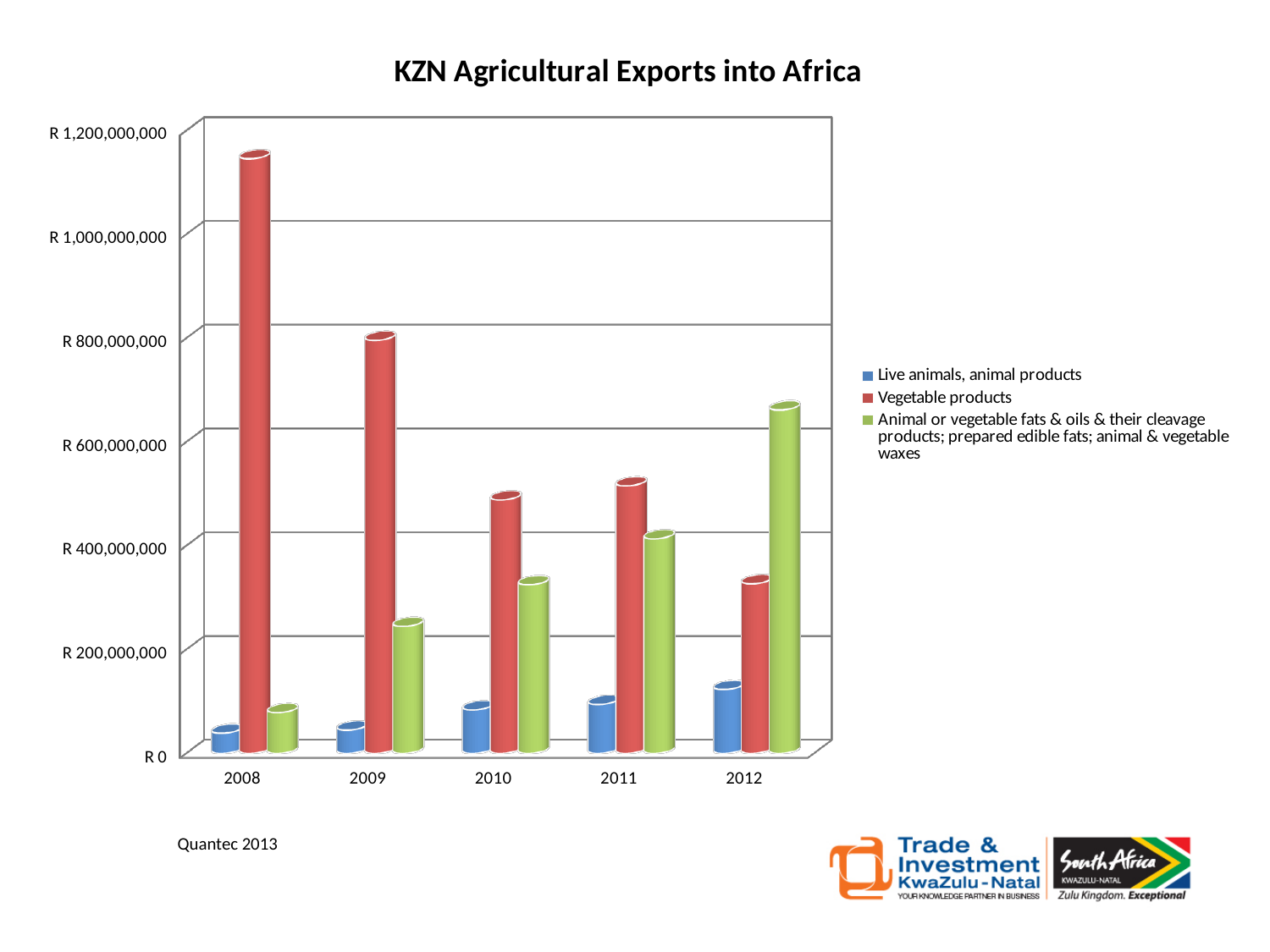
How many years are shown on the x axis? 5 In which year were Vegetable products exports highest? 2008 How many series does the legend list? 3 What is the data source cited below the chart? Quantec 2013 Is the value for Animal or vegetable fats & oils in 2012 greater or less than R 600,000,000? greater In which year were Vegetable products exports lowest? 2012 Is the value for Vegetable products in 2008 greater or less than R 1,000,000,000? greater Do the values for Live animals, animal products rise or fall from 2008 to 2012? Rise What kind of chart is shown on the slide? Bar chart Do the values for Animal or vegetable fats & oils rise or fall from 2008 to 2012? Rise In 2012, which is larger: Vegetable products or Animal or vegetable fats & oils? Animal or vegetable fats & oils In which year were exports of Animal or vegetable fats & oils highest? 2012